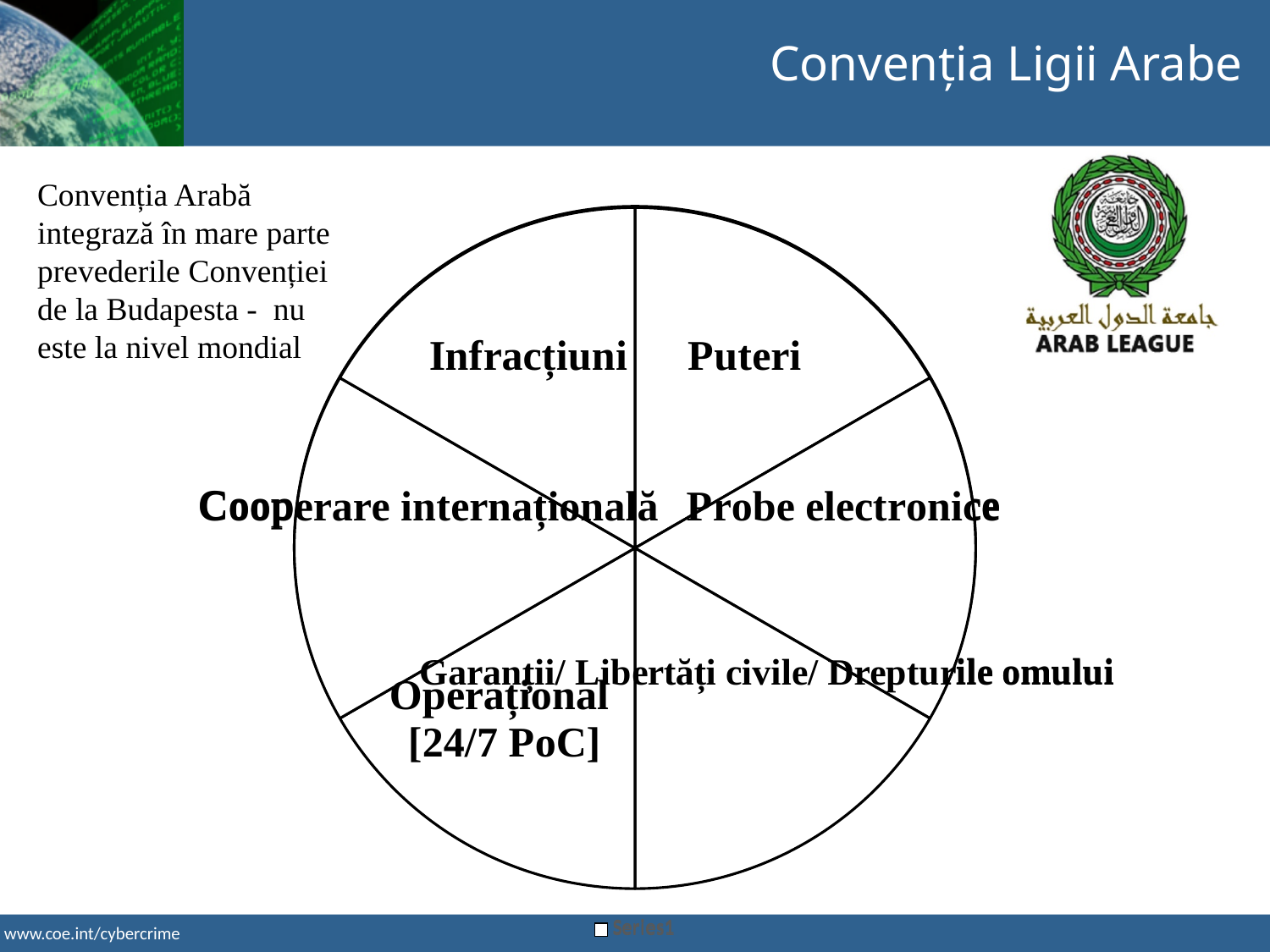
What kind of chart is shown on the slide? pie chart How many slices does the pie chart have? 6 Which slice label on the pie chart includes "[24/7 PoC]"? Operațional What is the title of the slide containing the pie chart? Convenția Ligii Arabe How many series does the legend at the bottom of the slide list? 1 What is the name of the series shown in the legend? Series1